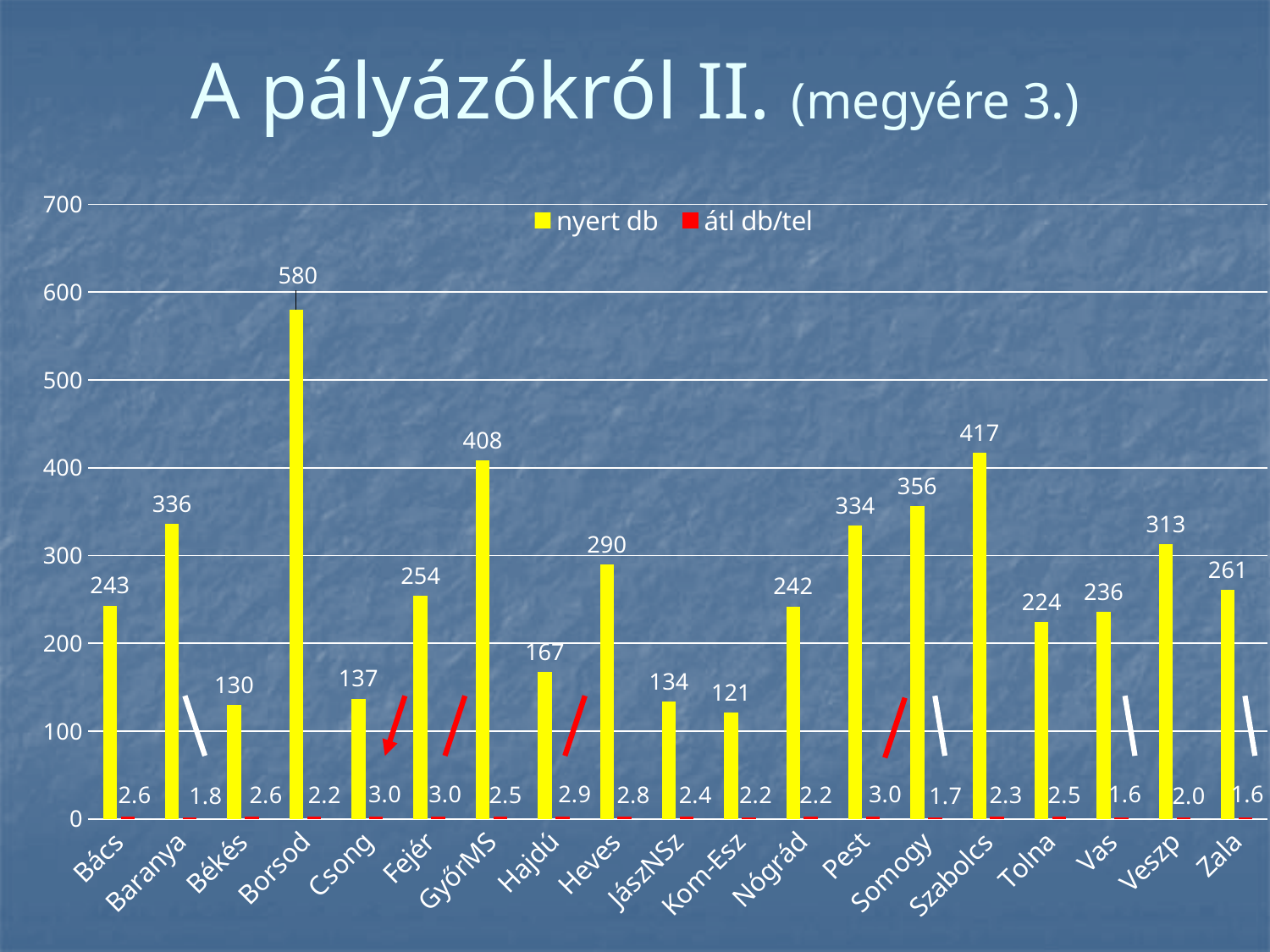
How many series does the legend list? 2 Which county has the highest nyert db value? Borsod What is the nyert db value for Borsod? 580 Which county has the lowest nyert db value? Kom-Esz How many counties are shown on the x axis? 19 Is the nyert db value for GyőrMS greater or less than 400? greater What is the difference in nyert db between Borsod and Szabolcs? 163 What colour are the nyert db bars? yellow Which has a larger nyert db value, Heves or Zala? Heves What is the átl db/tel value for Somogy? 1.7 What is the nyert db value for Szabolcs? 417 What kind of chart is shown on the slide? bar chart